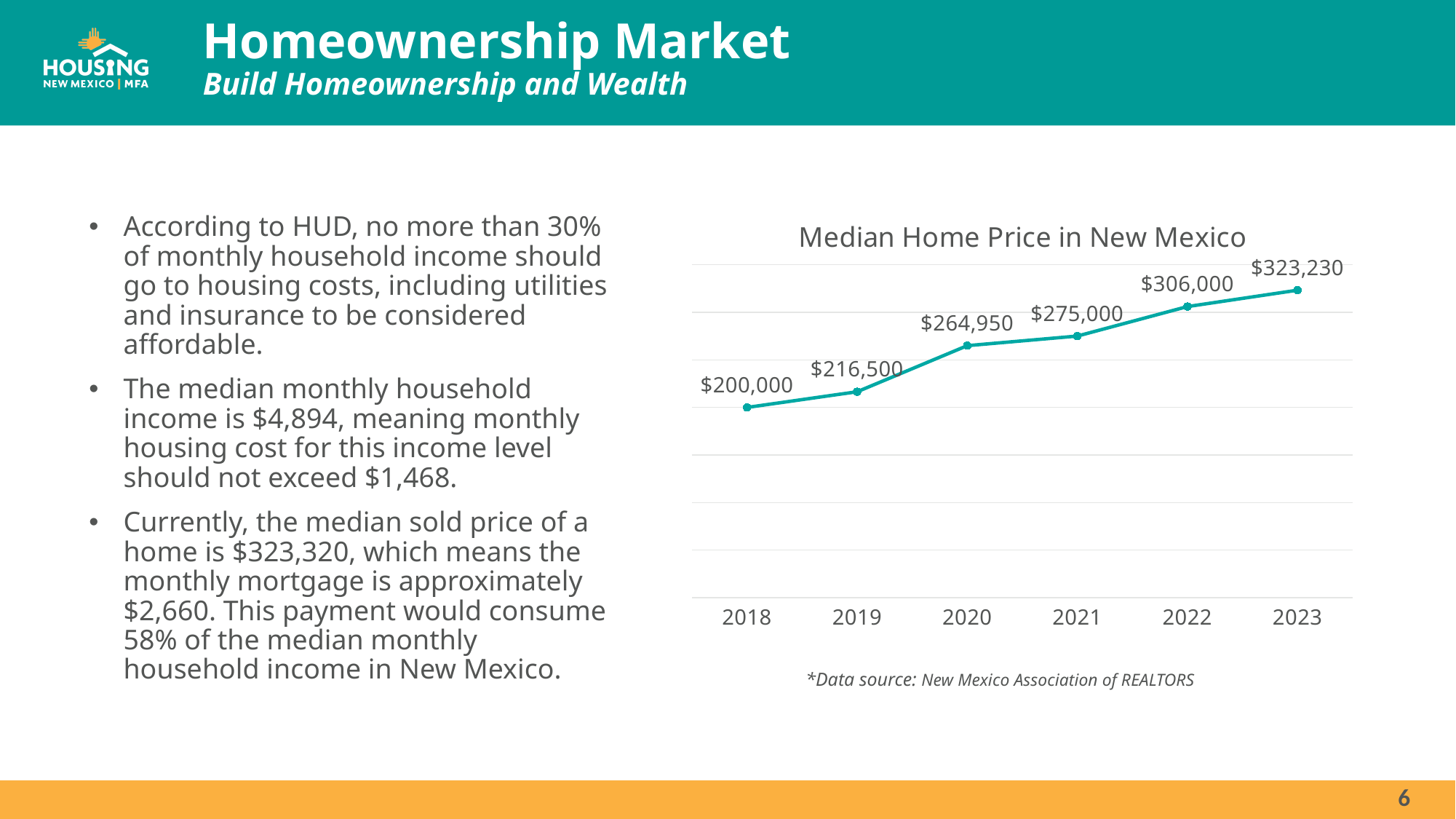
What is the median home price in New Mexico for 2023? $323,230 What is the median home price in New Mexico for 2018? $200,000 How many years are plotted on the chart? 6 What is the median home price in New Mexico for 2020? $264,950 What kind of chart is shown on the slide? Line chart Does the median home price rise or fall from 2018 to 2023? Rise What is the difference between the median home price in 2023 and in 2018? $123,230 Which year has the lowest median home price? 2018 Which year has the highest median home price? 2023 What is the difference between the median home price in 2019 and in 2018? $16,500 Which year has a higher median home price, 2021 or 2022? 2022 What is the median home price in New Mexico for 2022? $306,000